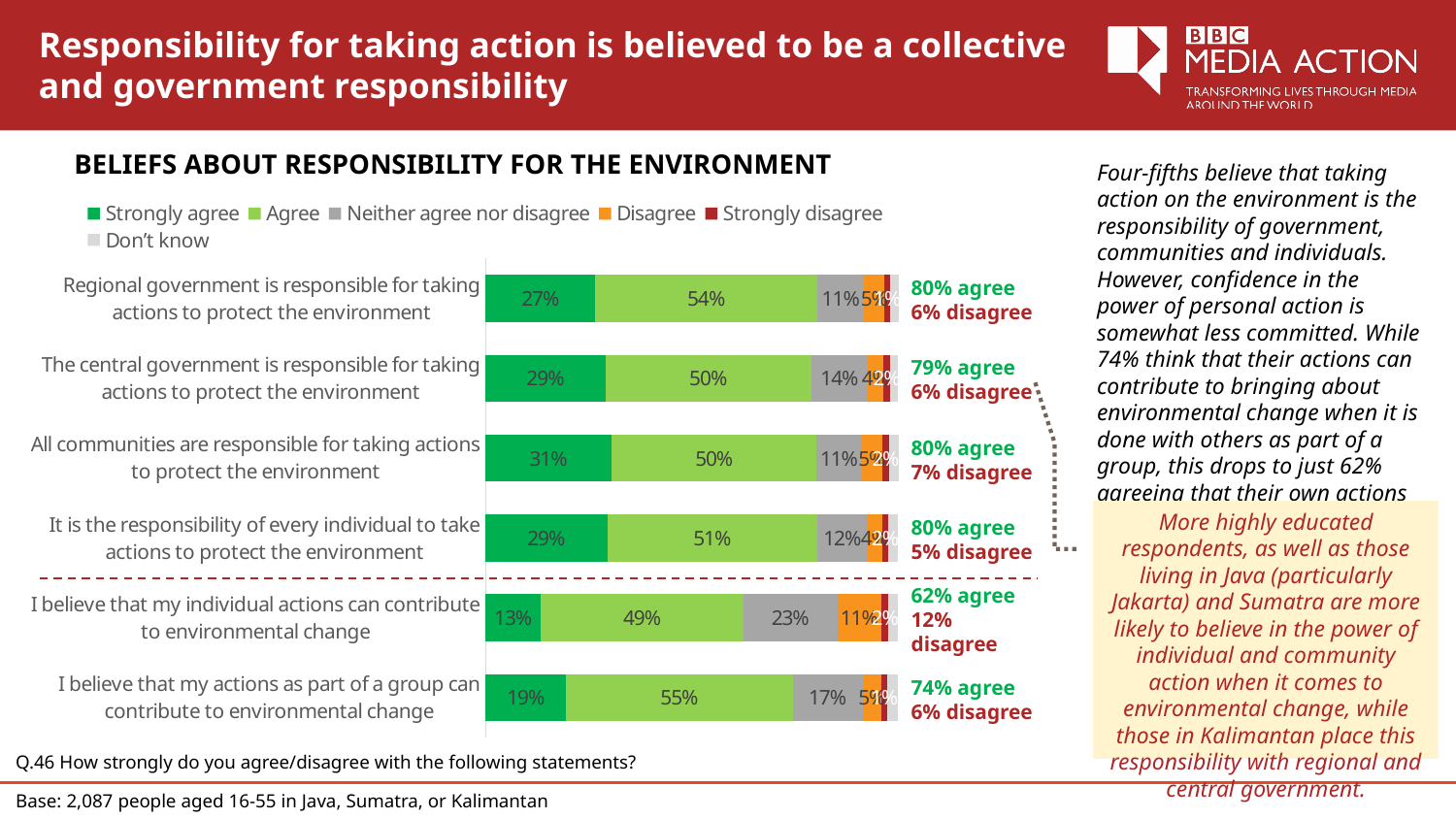
What kind of chart is shown on the slide? Stacked bar chart How many statements (categories) are plotted in the chart? 6 What percentage neither agree nor disagree with the statement 'I believe that my individual actions can contribute to environmental change'? 23% How many series does the chart legend list? 6 Which is larger: the 'Agree' percentage for the regional government statement or for the central government statement? Regional government (54%) What percentage strongly agree that regional government is responsible for taking actions to protect the environment? 27% What is the total agree percentage shown for the statement 'I believe that my individual actions can contribute to environmental change'? 62% agree What is the difference between the 'Strongly agree' percentages for the central government statement and the individual actions statement? 16% What percentage agree (not strongly) that their actions as part of a group can contribute to environmental change? 55% Which statement has the highest 'Strongly agree' percentage? All communities are responsible for taking actions to protect the environment Which statement has the lowest 'Strongly agree' percentage? I believe that my individual actions can contribute to environmental change What is the title of the chart? BELIEFS ABOUT RESPONSIBILITY FOR THE ENVIRONMENT